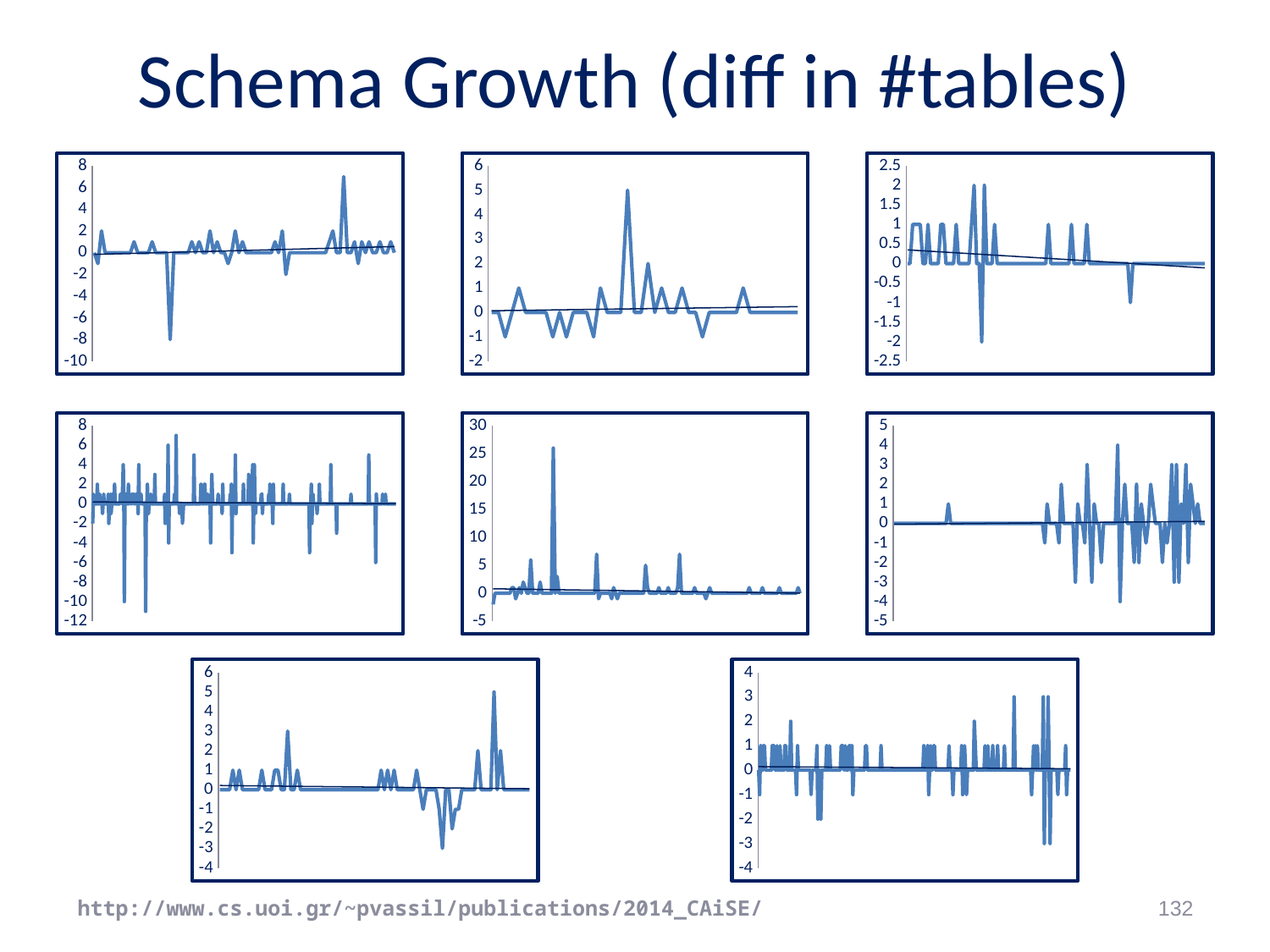
In the right chart of the second row, is the highest peak greater or less than 3? greater How many charts are shown on the slide? 8 In the left chart of the second row, is the lowest dip greater or less than -8? less In the bottom-left chart, is the highest peak greater or less than 4? greater What is the maximum value shown on the vertical axis of the middle chart in the second row? 30 In the top-right chart, does the straight trend line rise or fall from left to right? fall What kind of chart is the top-left chart on the slide? line chart